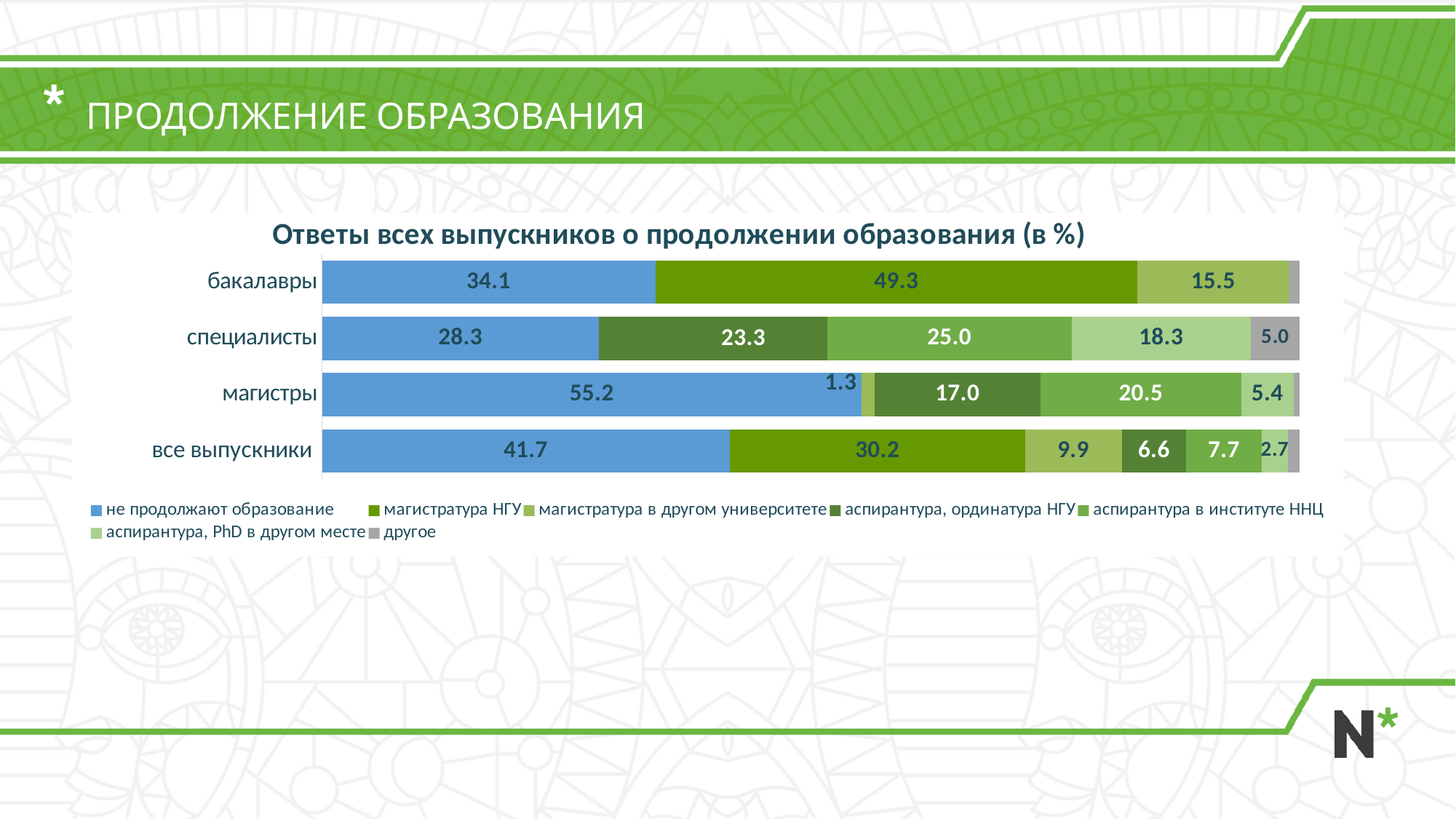
What is the value of "другое" for специалисты? 5.0 For бакалавры, which is larger: "не продолжают образование" or "магистратура НГУ"? магистратура НГУ Which category has the lowest value for "не продолжают образование"? специалисты What is the difference between the "не продолжают образование" values for магистры and все выпускники? 13.5 What is the value of "не продолжают образование" for магистры? 55.2 What is the title of the chart? Ответы всех выпускников о продолжении образования (в %) What kind of chart is shown on the slide? stacked bar chart How many categories (groups of graduates) are shown on the chart? 4 What is the value of "магистратура НГУ" for все выпускники? 30.2 Which category has the highest value for "не продолжают образование"? магистры How many series does the legend list? 7 What is the value of "магистратура НГУ" for бакалавры? 49.3